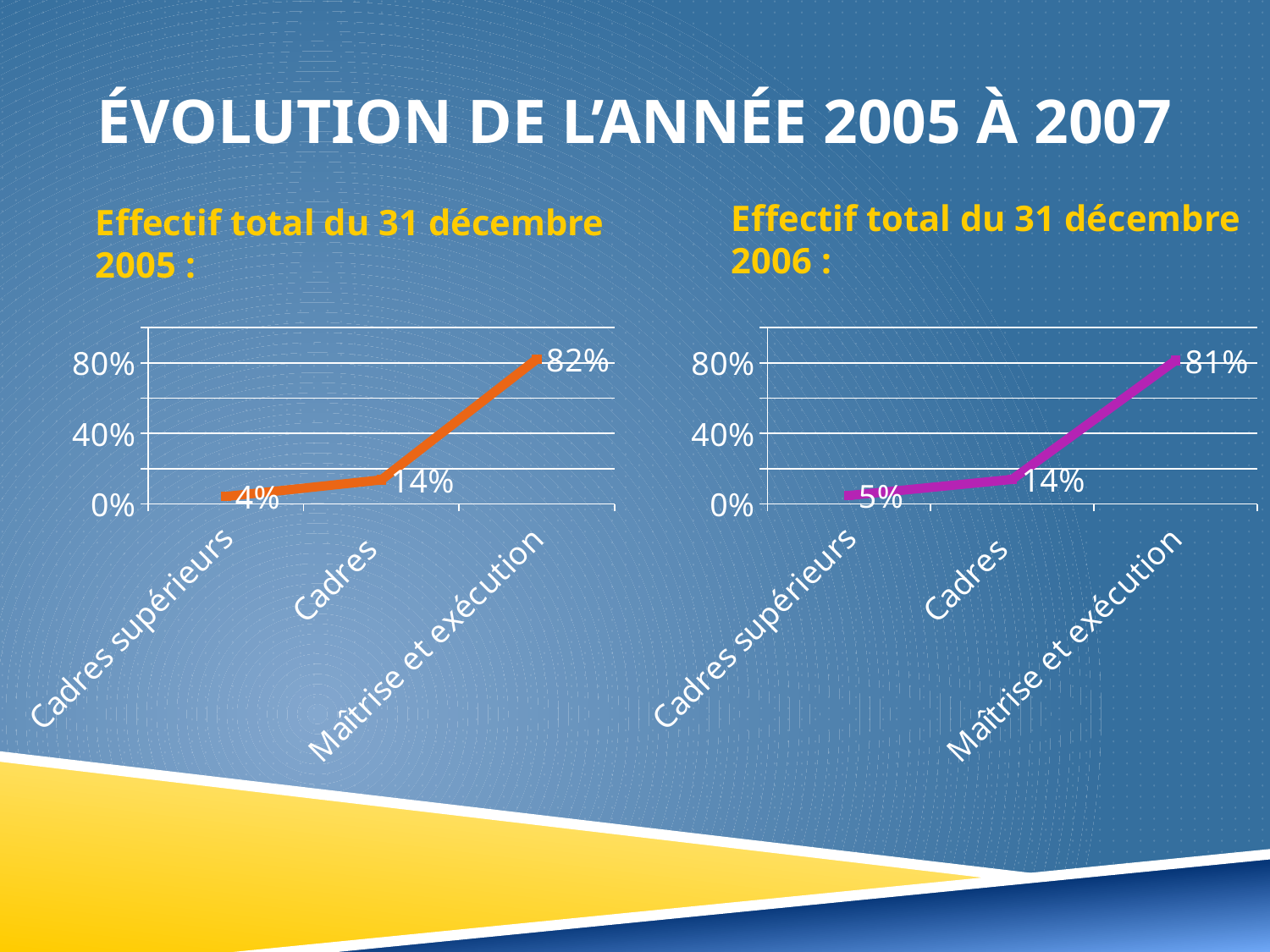
In the right chart (Effectif total du 31 décembre 2006), is the value for Maîtrise et exécution greater or less than 40%? greater In the right chart (Effectif total du 31 décembre 2006), which category has the highest value? Maîtrise et exécution In the left chart (Effectif total du 31 décembre 2005), what is the value for Cadres? 14% In the right chart (Effectif total du 31 décembre 2006), what is the difference between the values for Cadres and Cadres supérieurs? 9% Which is larger: the value for Maîtrise et exécution in the left chart (2005) or in the right chart (2006)? Left chart (2005) How many categories are plotted in the left chart (Effectif total du 31 décembre 2005)? 3 In the left chart (Effectif total du 31 décembre 2005), do the values rise or fall from Cadres supérieurs to Maîtrise et exécution? Rise In the left chart (Effectif total du 31 décembre 2005), what is the difference between the values for Maîtrise et exécution and Cadres? 68% In the left chart (Effectif total du 31 décembre 2005), what is the value for Maîtrise et exécution? 82% In the left chart (Effectif total du 31 décembre 2005), which category has the lowest value? Cadres supérieurs What kind of chart is the right chart (Effectif total du 31 décembre 2006)? Line chart In the right chart (Effectif total du 31 décembre 2006), what is the value for Cadres supérieurs? 5%